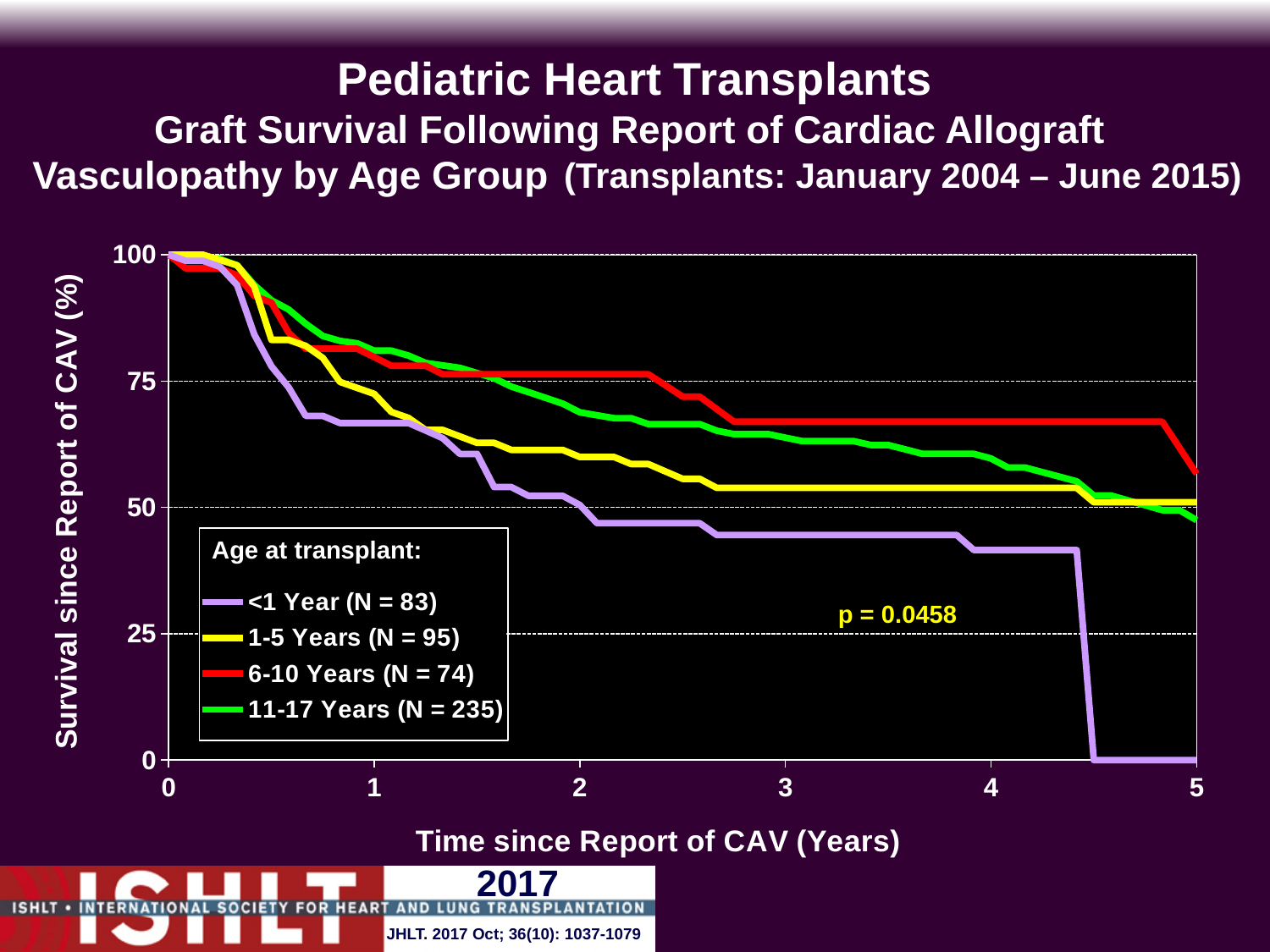
Is the survival for the <1 Year group at 3 years since report of CAV greater or less than 50? less What is the N for the <1 Year age group in the legend? 83 Do the survival curves rise or fall as time since report of CAV increases? fall What kind of chart is shown on the slide? line chart At 3 years since report of CAV, which has higher survival: the 6-10 Years group or the <1 Year group? 6-10 Years Which age group has the lowest survival at 3 years since report of CAV? <1 Year Is the survival for the 11-17 Years group at 2 years since report of CAV greater or less than 75? less Which age group has the smallest N in the legend? 6-10 Years Is the survival for the 6-10 Years group at 3 years since report of CAV greater or less than 50? greater How many age groups does the legend list? 4 What is the N for the 11-17 Years age group in the legend? 235 What p-value is printed on the chart? p = 0.0458